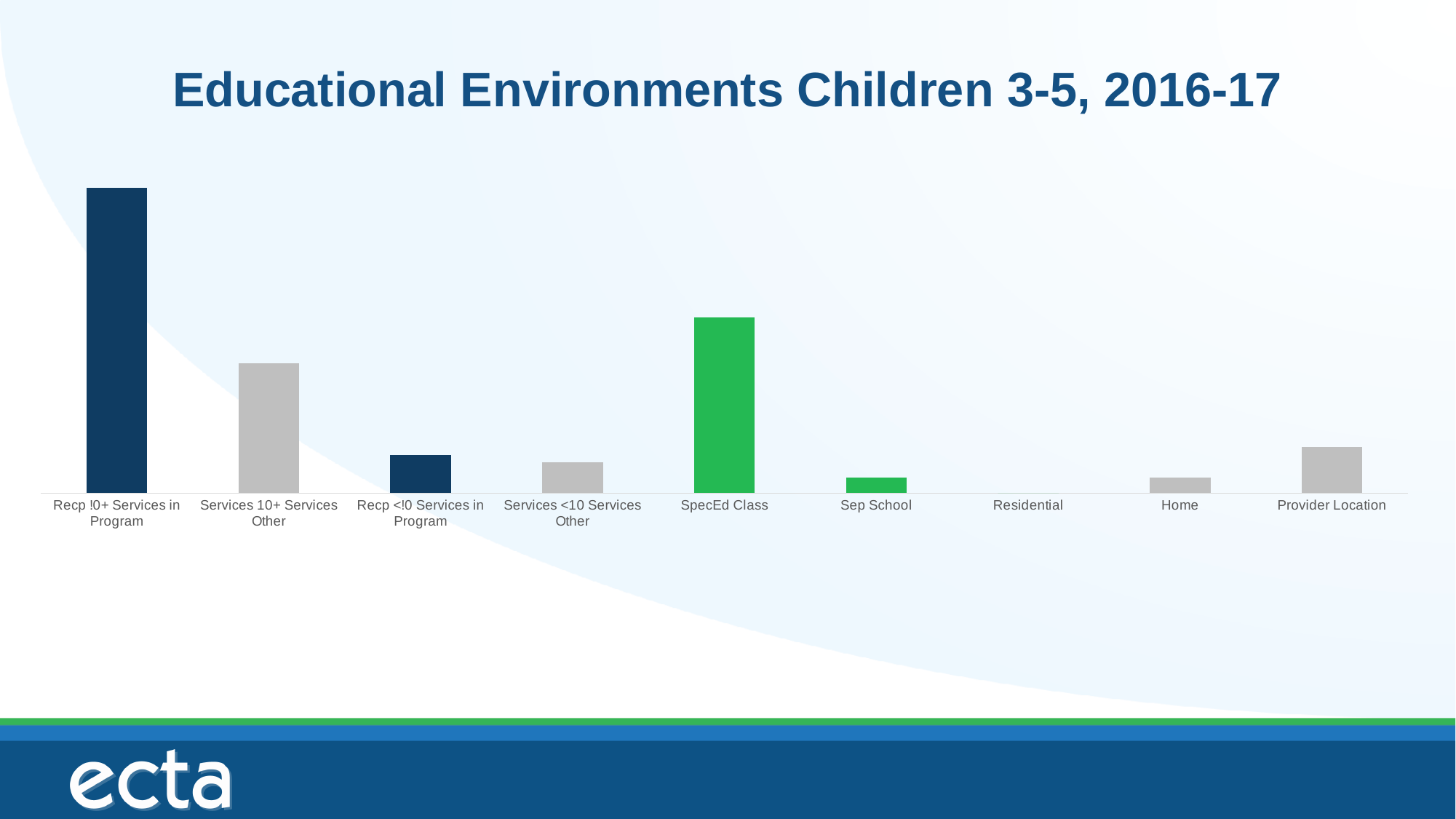
Which category has the highest bar? Recp !0+ Services in Program Which category has the second-highest bar? SpecEd Class What is the title of the chart? Educational Environments Children 3-5, 2016-17 Which category has the lowest value (no visible bar)? Residential What kind of chart is shown on the slide? Bar chart Which is larger, the value for Recp !0+ Services in Program or the value for Services 10+ Services Other? Recp !0+ Services in Program Which is larger, the value for Provider Location or the value for Sep School? Provider Location Which is larger, the value for Provider Location or the value for Home? Provider Location What colour are the bars for SpecEd Class and Sep School? Green How many categories are shown on the x axis of the chart? 9